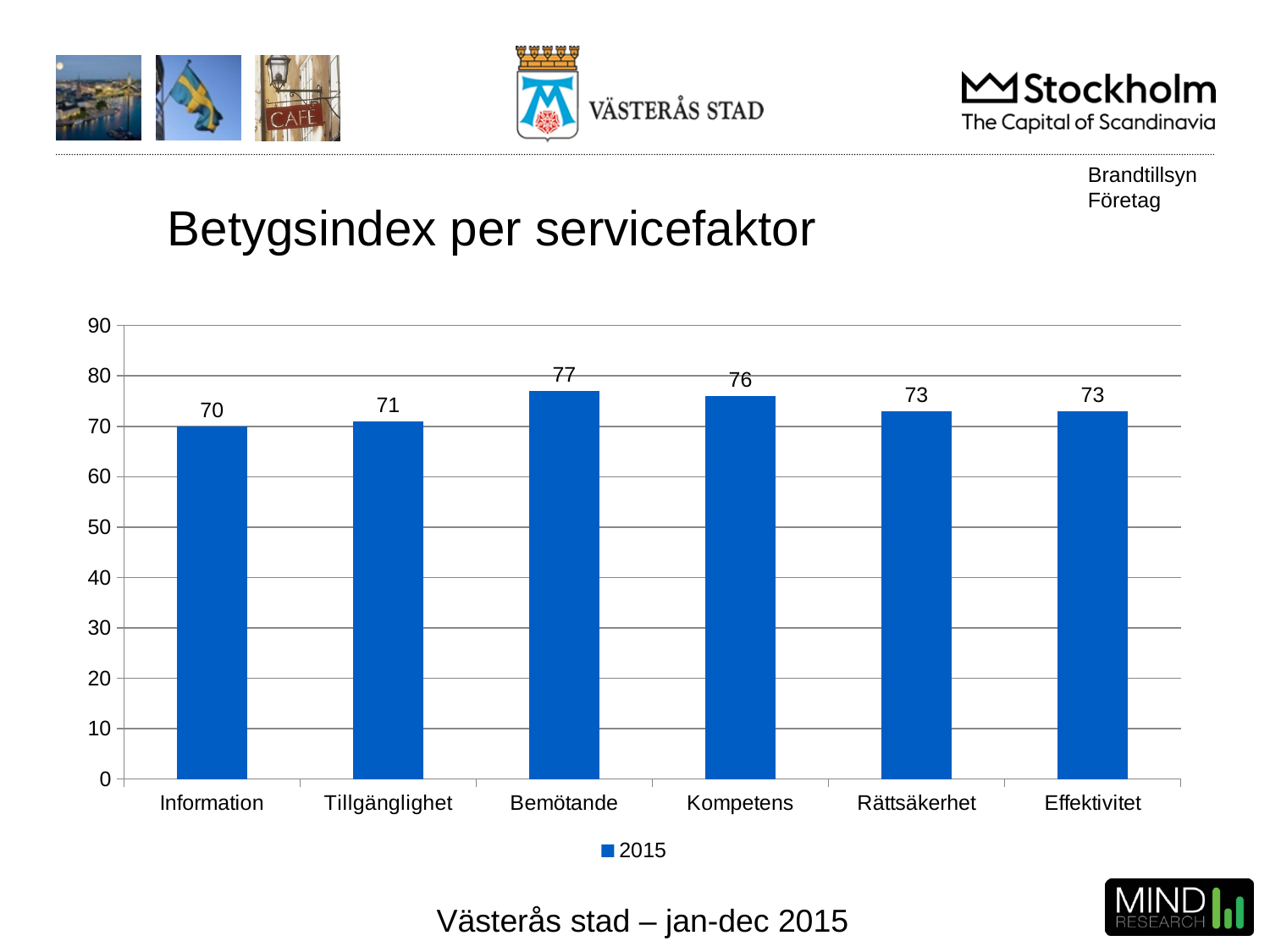
Which is larger, the value for Kompetens or the value for Tillgänglighet? Kompetens What is the title of the chart? Betygsindex per servicefaktor What kind of chart is shown? bar chart Which service factor has the highest value? Bemötande What is the value for Information? 70 Which service factor has the lowest value? Information How many service factors are shown on the x axis? 6 What is the value for Rättsäkerhet? 73 Is the value for Effektivitet greater or less than 60? greater How many series does the legend list? 1 What is the value for Bemötande? 77 What is the difference between the values for Bemötande and Information? 7